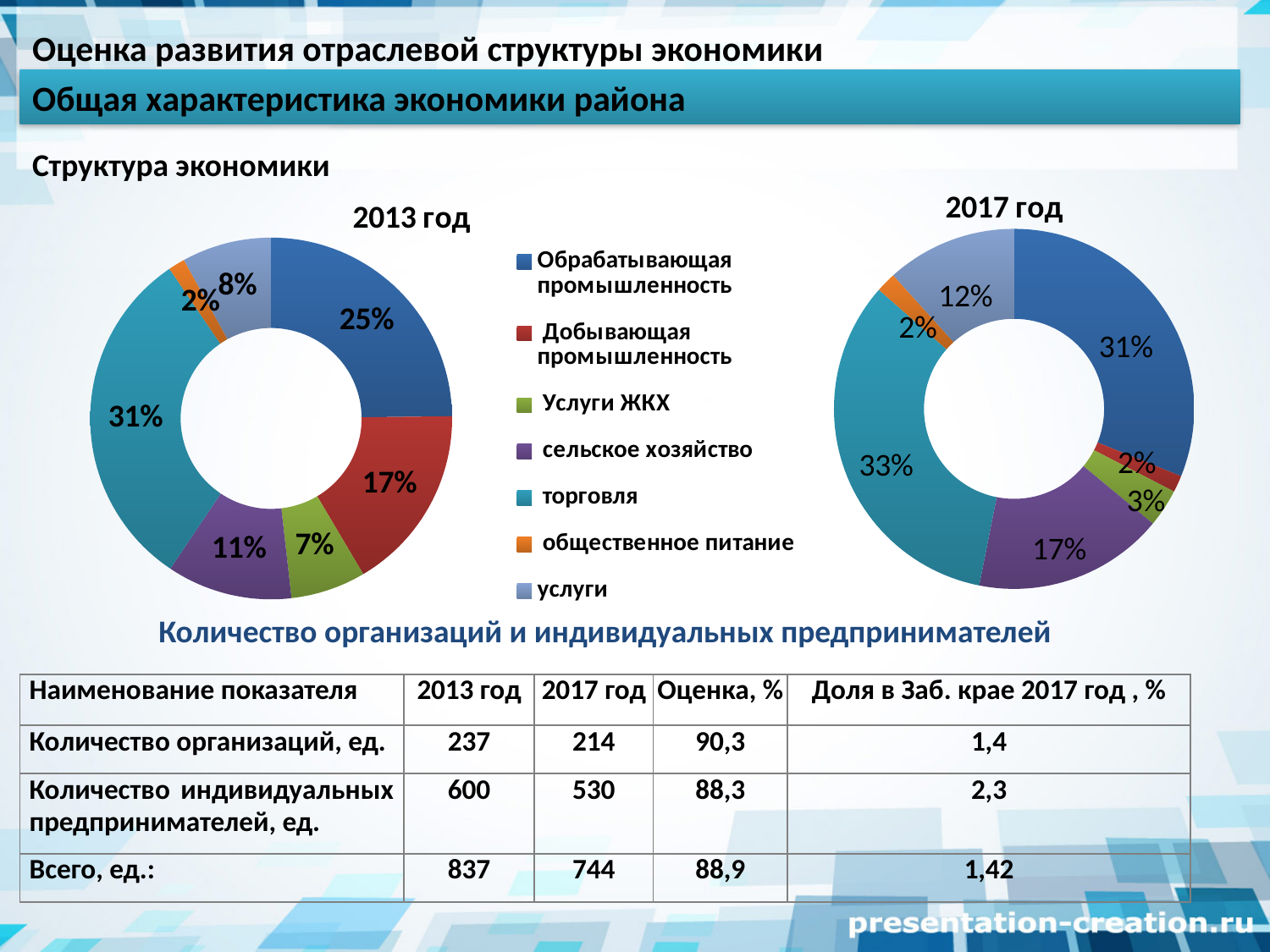
What type of chart is the 2013 год chart? Doughnut (pie) chart In the 2017 год chart, what is the difference between Обрабатывающая промышленность and сельское хозяйство? 14 percentage points In the 2017 год chart, which category has the largest share? торговля How many categories does the 2017 год chart show? 7 In the 2013 год chart, what is the difference between торговля and Обрабатывающая промышленность? 6 percentage points In the 2017 год chart, what is the value for услуги? 12% In the 2013 год chart, which category has the smallest share? общественное питание In the 2013 год chart, which is larger: Добывающая промышленность or сельское хозяйство? Добывающая промышленность Which colour represents торговля in the legend? Teal In the 2017 год chart, what share does Обрабатывающая промышленность have? 31% In the 2013 год chart, what share does торговля have? 31% In the 2013 год chart, what is the value for Добывающая промышленность? 17%